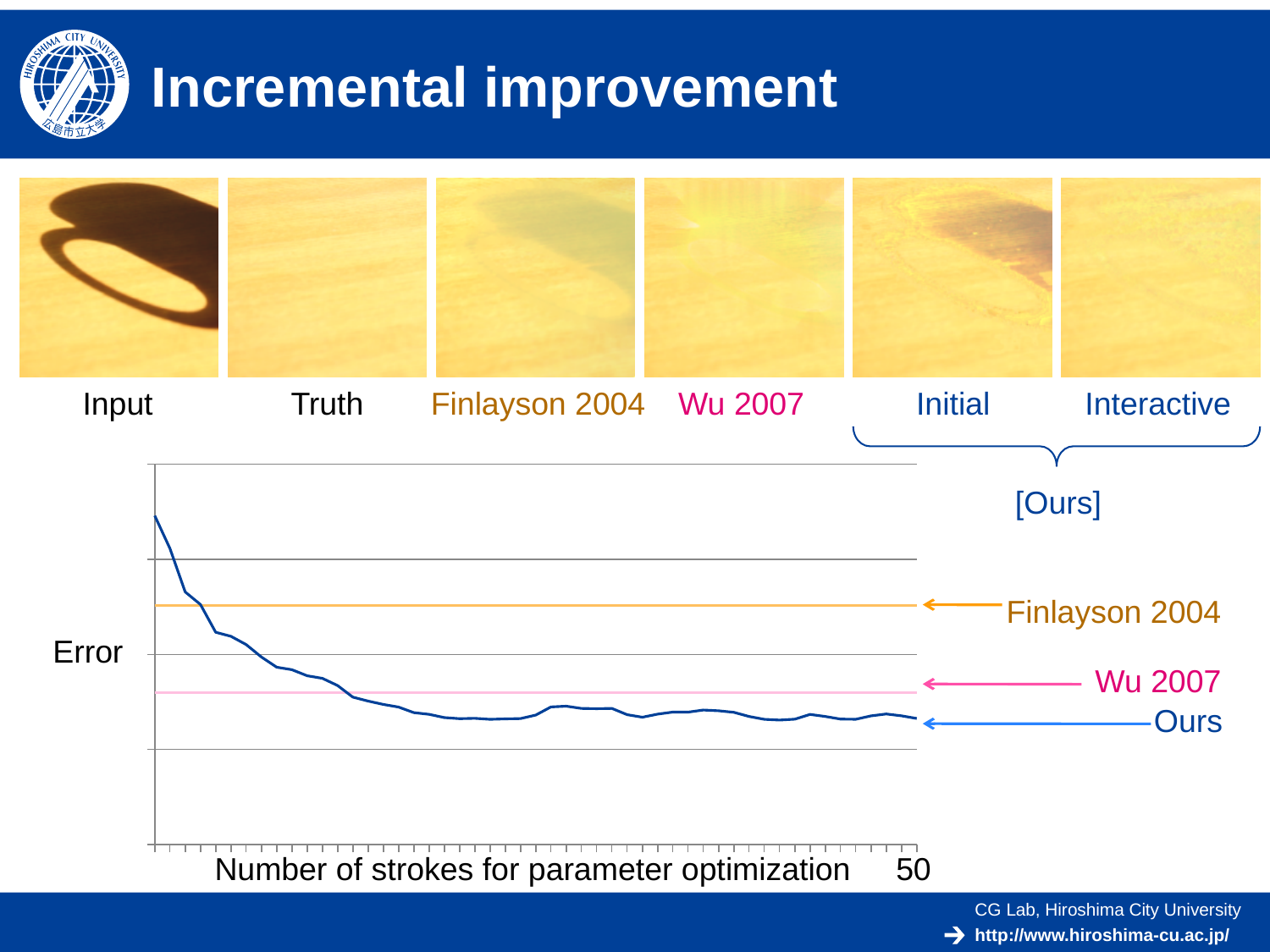
Does the error for Ours rise or fall as the number of strokes increases? fall Which method has the lowest error at 50 strokes? Ours Which has the larger error at 50 strokes, Wu 2007 or Ours? Wu 2007 What is the label of the y axis of the chart? Error What is the value shown at the right end of the x axis? 50 Which has the larger error, Finlayson 2004 or Wu 2007? Finlayson 2004 Which plotted line changes with the number of strokes rather than staying constant? Ours How many labelled lines are plotted on the chart? 3 What kind of chart is shown on the slide? line chart What is the label of the x axis of the chart? Number of strokes for parameter optimization